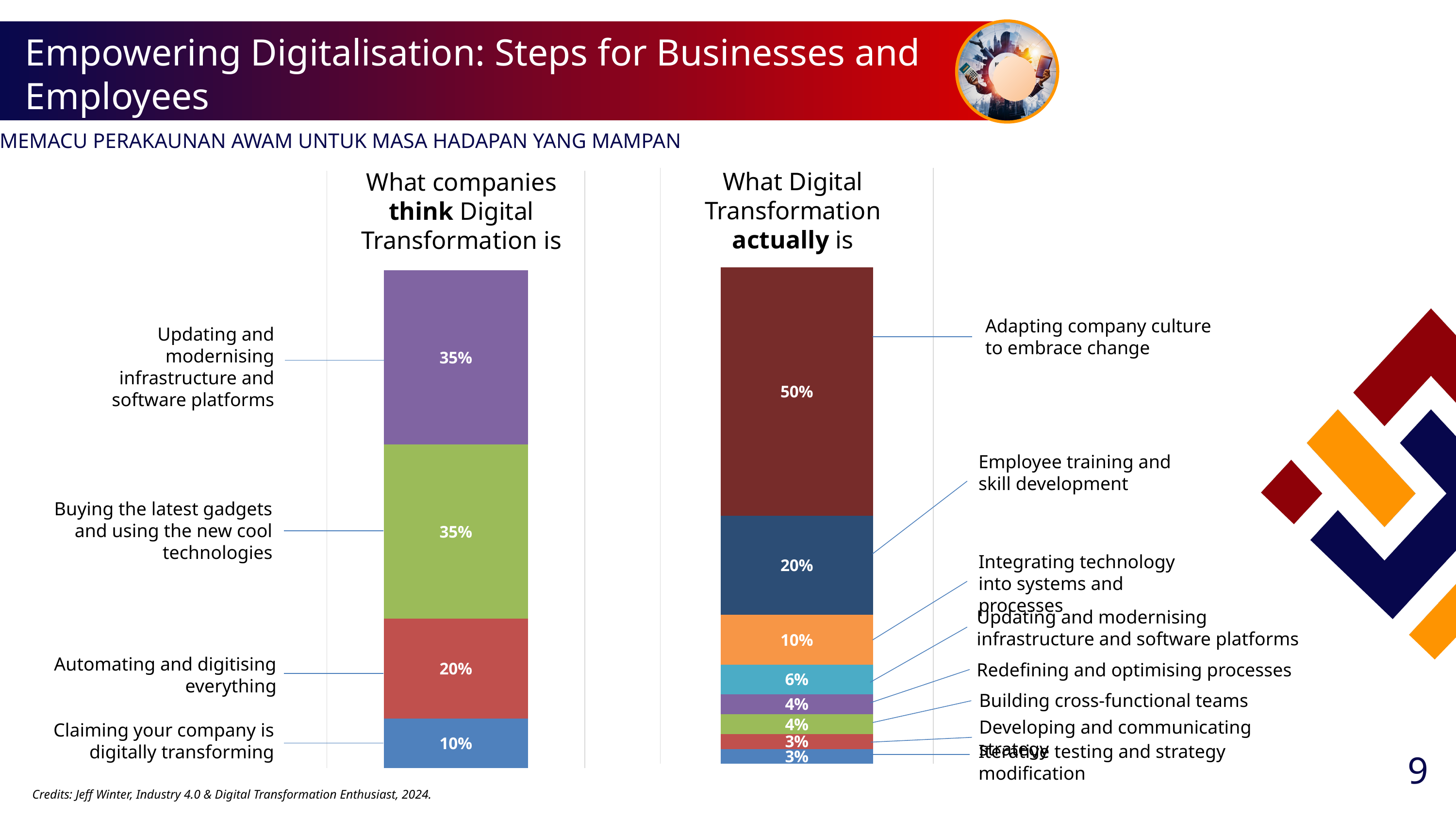
In the chart titled "What companies think Digital Transformation is", what percentage is shown for "Claiming your company is digitally transforming"? 10% In the chart titled "What Digital Transformation actually is", which segment has the largest percentage? Adapting company culture to embrace change In the chart titled "What companies think Digital Transformation is", which is larger: "Buying the latest gadgets and using the new cool technologies" or "Automating and digitising everything"? Buying the latest gadgets and using the new cool technologies In the chart titled "What Digital Transformation actually is", what percentage is shown for "Employee training and skill development"? 20% In the chart titled "What companies think Digital Transformation is", what percentage is shown for "Automating and digitising everything"? 20% What type of chart is used on this slide to show what companies think Digital Transformation is? Stacked bar chart In the chart titled "What companies think Digital Transformation is", which segment has the smallest percentage? Claiming your company is digitally transforming How many segments make up the stacked bar in the chart titled "What companies think Digital Transformation is"? 4 In the chart titled "What Digital Transformation actually is", what percentage is shown for "Integrating technology into systems and processes"? 10% How many segments make up the stacked bar in the chart titled "What Digital Transformation actually is"? 8 In the chart titled "What Digital Transformation actually is", what percentage is shown for "Adapting company culture to embrace change"? 50% In the chart titled "What Digital Transformation actually is", what is the difference between the percentages for "Adapting company culture to embrace change" and "Employee training and skill development"? 30%